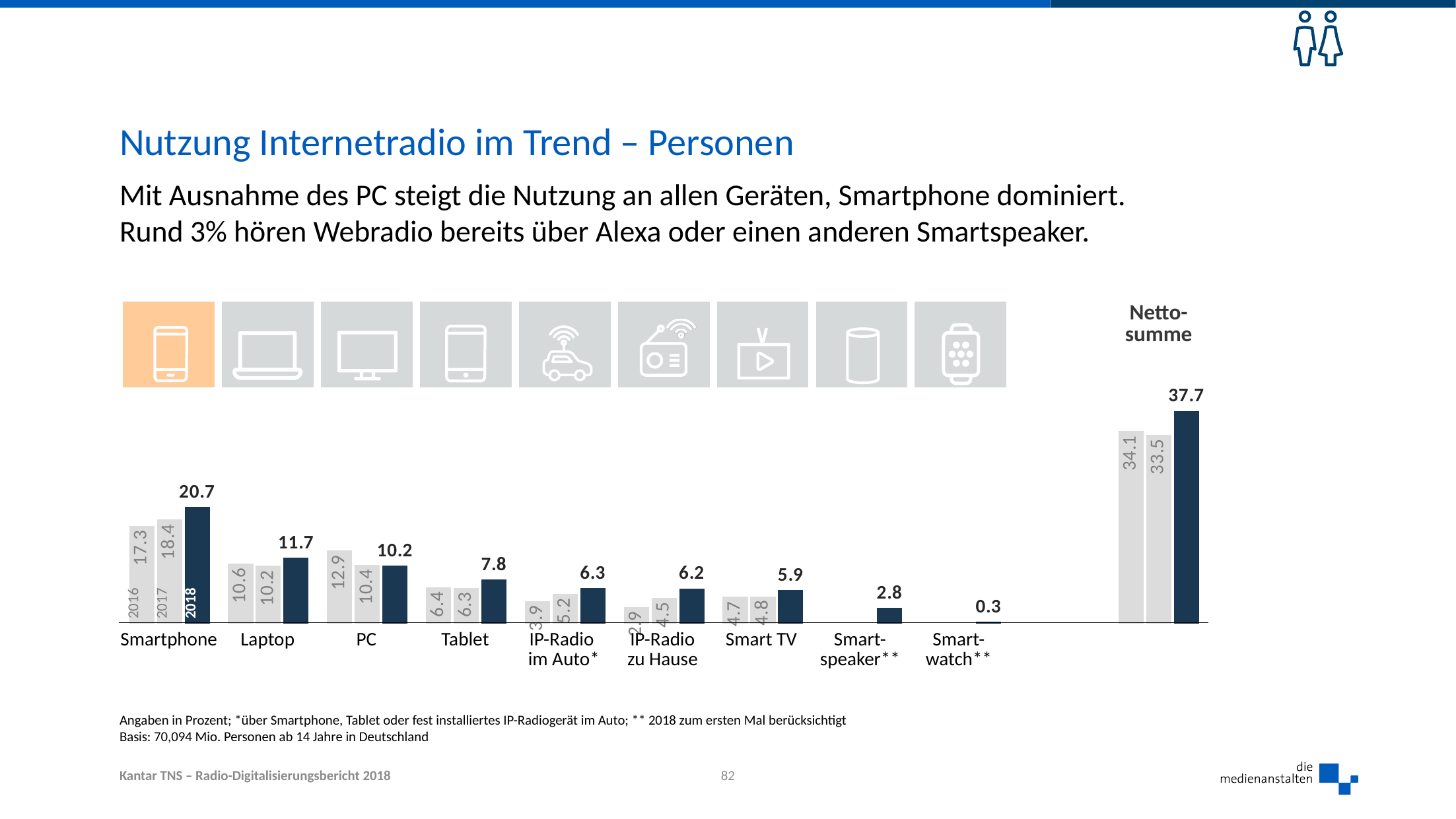
Do the values for Tablet rise or fall from 2016 to 2018? rise What kind of chart is shown on the slide? bar chart What is the 2018 value for the Netto-summe? 37.7 What is the 2018 value for Smartspeaker**? 2.8 What is the 2018 value for Smartphone? 20.7 What is the 2017 value for Laptop? 10.2 What is the difference between the 2018 and 2016 values for Smartphone? 3.4 Excluding the Netto-summe, which device has the highest 2018 value? Smartphone What is the 2016 value for PC? 12.9 Which is larger for PC: the 2016 value or the 2018 value? 2016 Which device has the lowest 2018 value? Smartwatch** How many years (series) are shown for the Smartphone category? 3